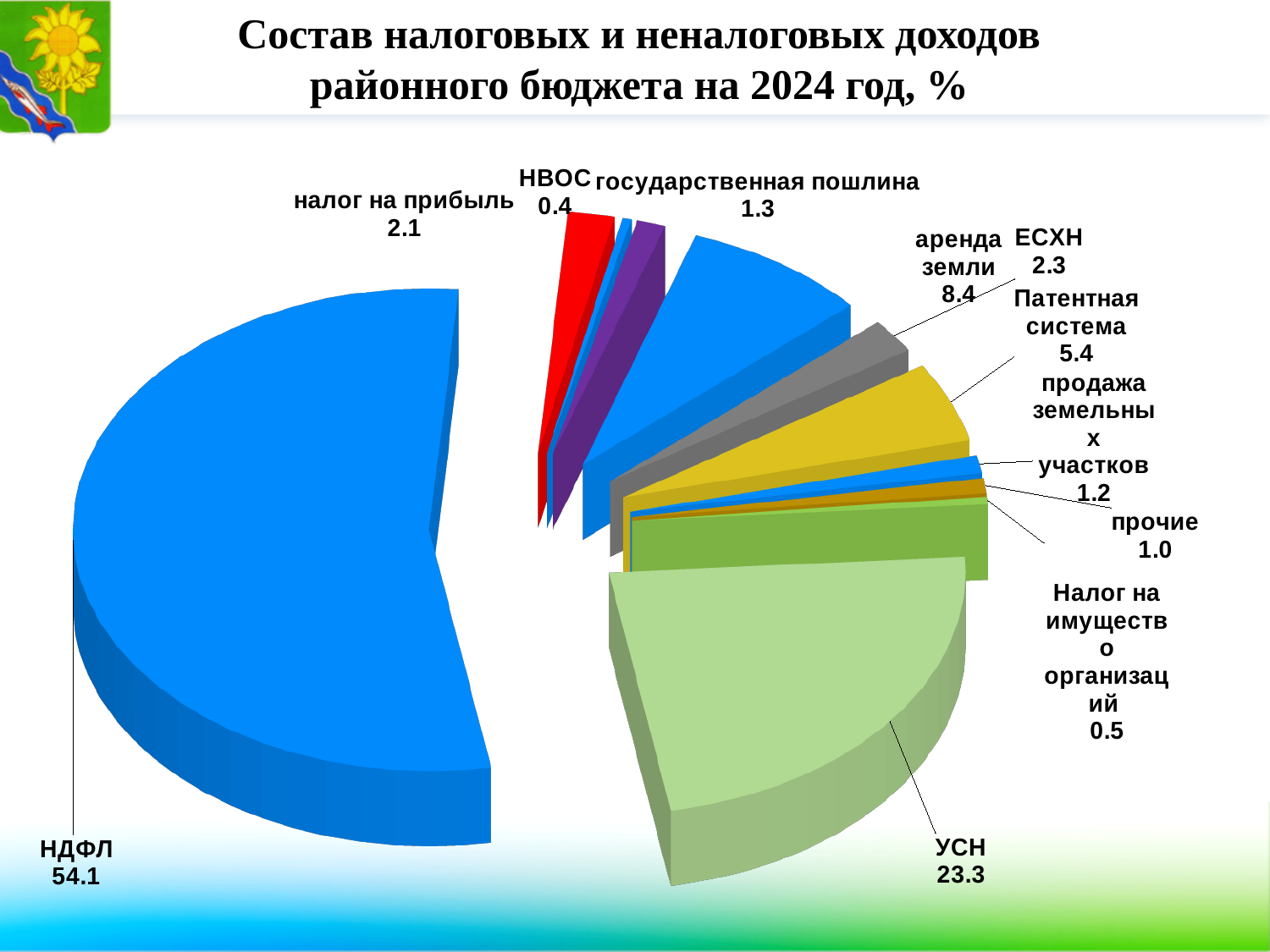
What is the value for УСН? 23.3 Which category has the smallest share of the pie? НВОС Which is larger, аренда земли or Патентная система? аренда земли Which category has the largest share of the pie? НДФЛ How many categories are shown in the pie chart? 11 What is the value for аренда земли? 8.4 What is the value for Патентная система? 5.4 What is the value for НДФЛ? 54.1 What is the title of the chart? Состав налоговых и неналоговых доходов районного бюджета на 2024 год, % What type of chart is shown on the slide? Pie chart What is the value for НВОС? 0.4 What is the difference between the values for НДФЛ and УСН? 30.8